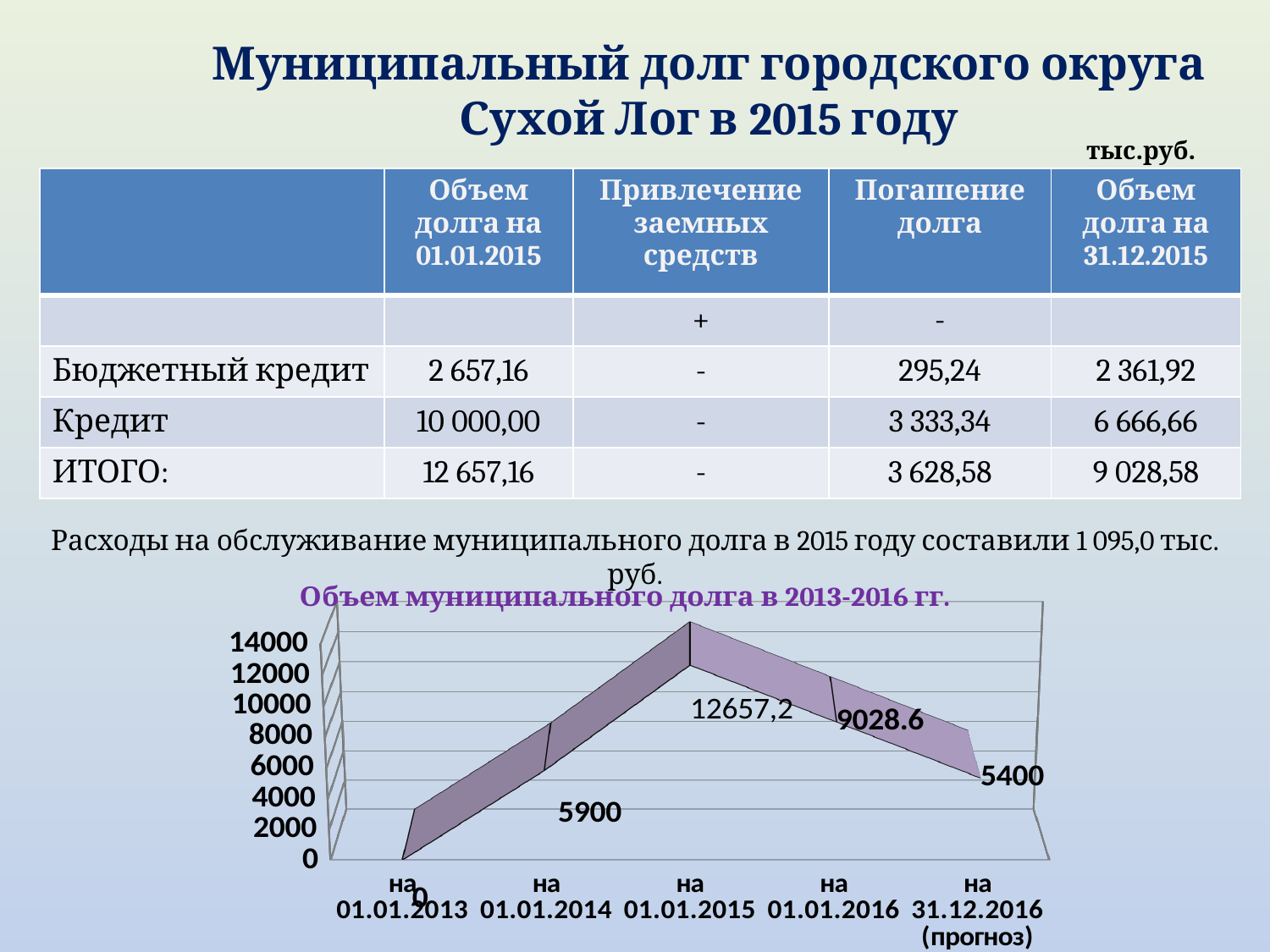
Which date has the highest value on the chart? на 01.01.2015 How many data points are plotted on the chart? 5 Which date has the lowest value on the chart? на 01.01.2013 What is the value for на 31.12.2016 (прогноз) on the chart? 5400 Do the values on the chart rise or fall from на 01.01.2015 to на 31.12.2016 (прогноз)? fall What is the value for на 01.01.2015 on the chart? 12657,2 What is the value for на 01.01.2014 on the chart? 5900 What kind of chart is shown on the slide? line chart What is the value for на 01.01.2013 on the chart? 0 What is the title of the chart on the slide? Объем муниципального долга в 2013-2016 гг. Which is larger on the chart: the value for на 01.01.2014 or the value for на 31.12.2016 (прогноз)? на 01.01.2014 What is the value for на 01.01.2016 on the chart? 9028.6